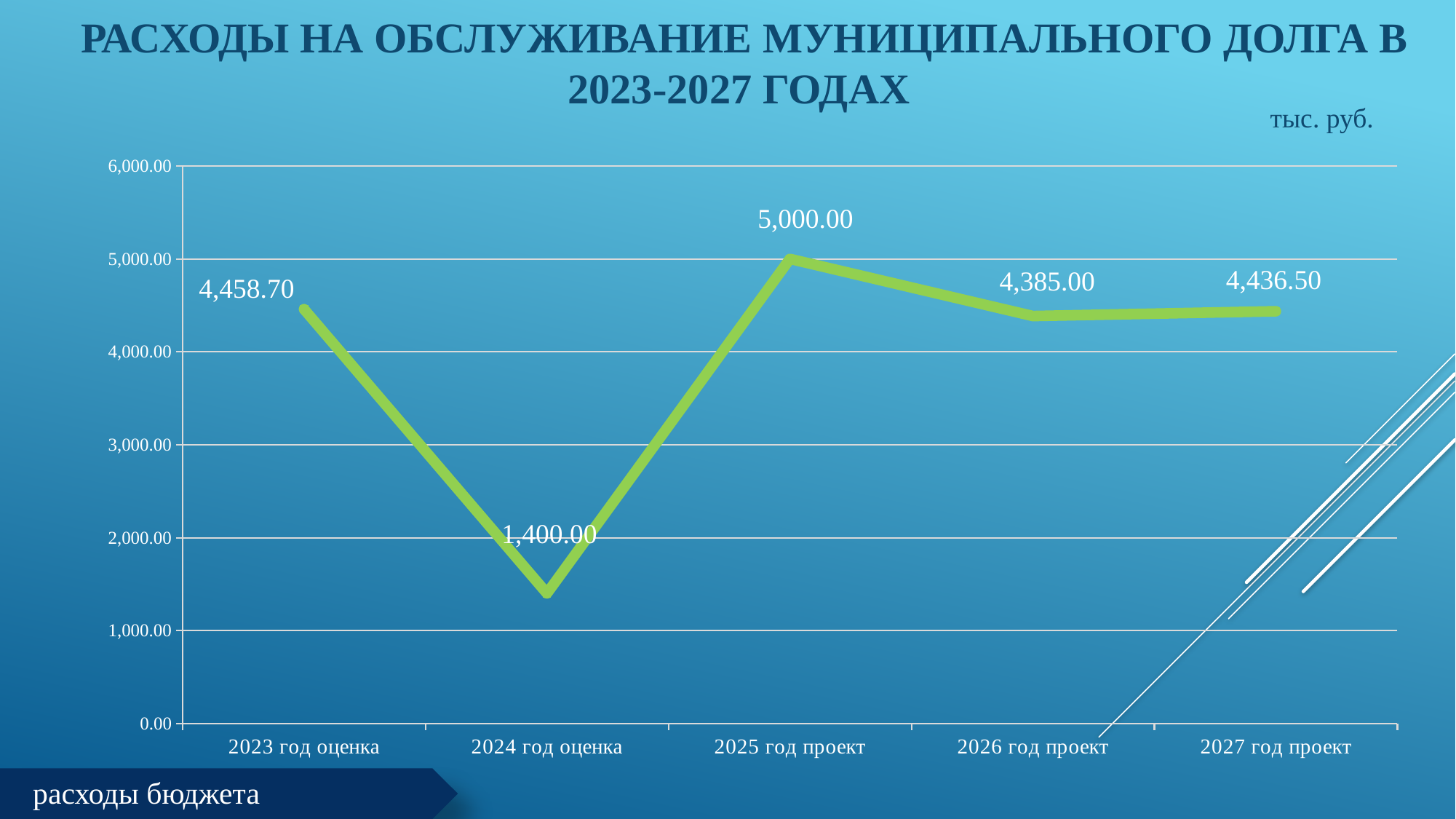
Which year has the lowest value? 2024 год оценка What is the value for 2027 год проект? 4,436.50 What is the value for 2024 год оценка? 1,400.00 What kind of chart is shown on the slide? line chart What is the difference between the values for 2023 год оценка and 2024 год оценка? 3,058.70 Which year has the highest value? 2025 год проект What is the value for 2023 год оценка? 4,458.70 Does the value rise or fall from 2023 год оценка to 2024 год оценка? fall Is the value for 2024 год оценка greater or less than 2,000.00? less How many data points are plotted on the chart? 5 What is the difference between the values for 2025 год проект and 2026 год проект? 615.00 Which is larger, the value for 2023 год оценка or 2026 год проект? 2023 год оценка